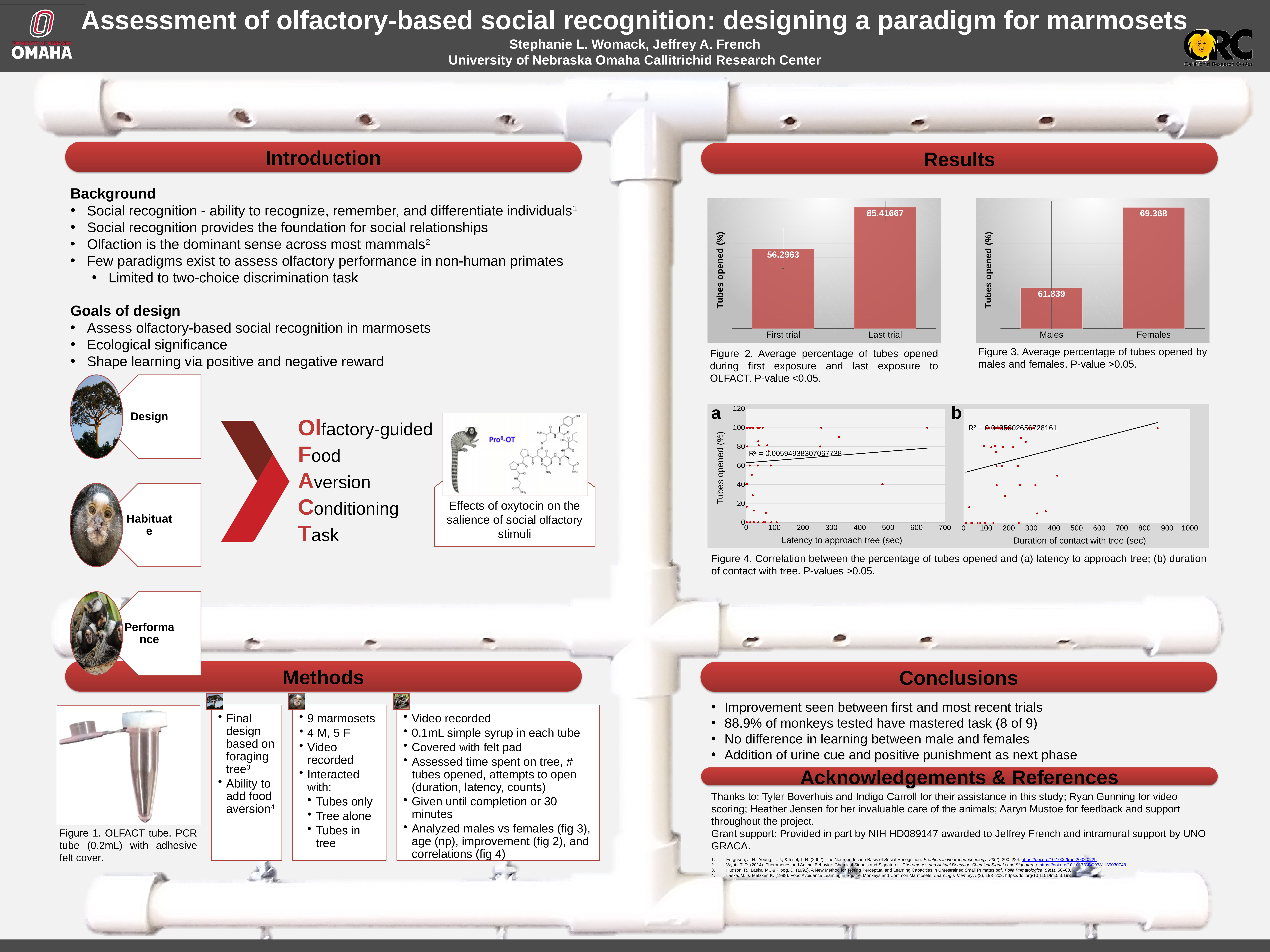
In Figure 4a (the scatter plot of tubes opened vs latency to approach tree), what is the x-axis label? Latency to approach tree (sec) In Figure 3 (the bar chart of males vs females), what is the value for Females? 69.368 In Figure 2 (the bar chart of first trial vs last trial), what is the value for First trial? 56.2963 What kind of chart is Figure 4a (tubes opened vs latency to approach tree)? Scatter plot What kind of chart is Figure 3 (males vs females)? Bar chart In Figure 2 (the bar chart of first trial vs last trial), how many bars are plotted? 2 In Figure 2 (the bar chart of first trial vs last trial), what is the difference between the Last trial and First trial values? 29.12037 In Figure 2 (the bar chart of first trial vs last trial), what is the value for Last trial? 85.41667 In Figure 3 (the bar chart of males vs females), what is the value for Males? 61.839 In Figure 2 (the bar chart of first trial vs last trial), which category has the higher percentage of tubes opened? Last trial In Figure 3 (the bar chart of males vs females), which group has the lower percentage of tubes opened? Males In Figure 3 (the bar chart of males vs females), what is the difference between the Females and Males values? 7.529